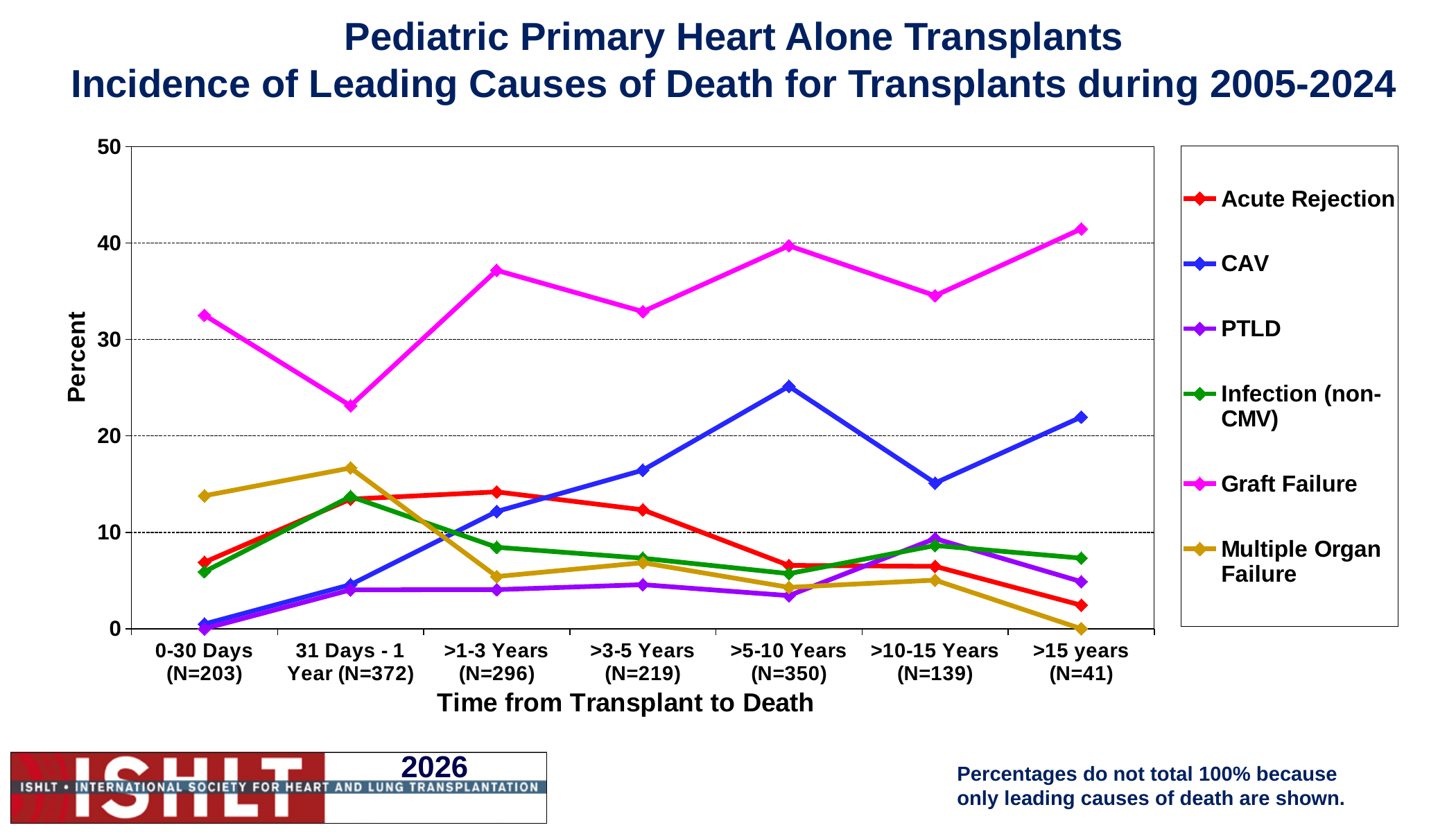
Is the value for Graft Failure at 31 Days - 1 Year greater or less than 30? less Is the value for CAV at >5-10 Years greater or less than 20? greater Does the CAV line rise or fall from 0-30 Days to >5-10 Years? Rises How many time periods are shown along the x axis? 7 Which cause of death has the lowest value at >15 years? Multiple Organ Failure How many series does the legend list? 6 Is the value for Graft Failure at >15 years greater or less than 40? greater What kind of chart is shown on the slide? Line chart What is the label of the y axis? Percent Which cause of death has the highest value at >5-10 Years? Graft Failure At 0-30 Days, which is larger: Multiple Organ Failure or Acute Rejection? Multiple Organ Failure